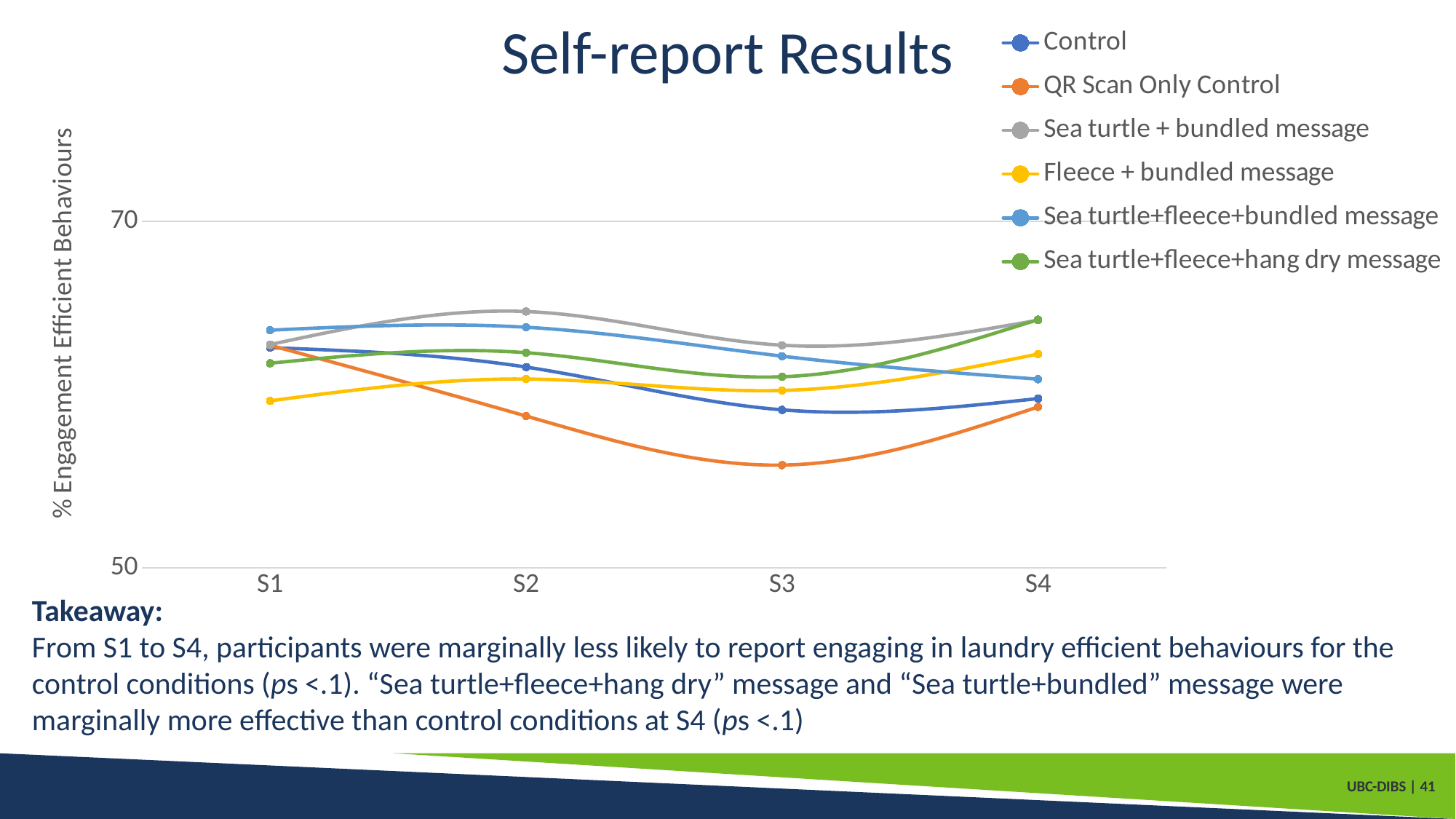
At S3, which is larger: Sea turtle + bundled message or QR Scan Only Control? Sea turtle + bundled message Is the value for QR Scan Only Control at S3 greater or less than 70? less Does the Sea turtle+fleece+hang dry message series rise or fall from S3 to S4? rise How many time points are shown along the x axis? 4 Which series has the highest value at S1? Sea turtle+fleece+bundled message How many series does the legend list? 6 Which series has the highest value at S2? Sea turtle + bundled message Which series has the lowest value at S3? QR Scan Only Control What is the label on the y axis? % Engagement Efficient Behaviours Which series has the lowest value at S1? Fleece + bundled message What kind of chart is shown on the slide? line chart Does the QR Scan Only Control series rise or fall from S1 to S3? fall